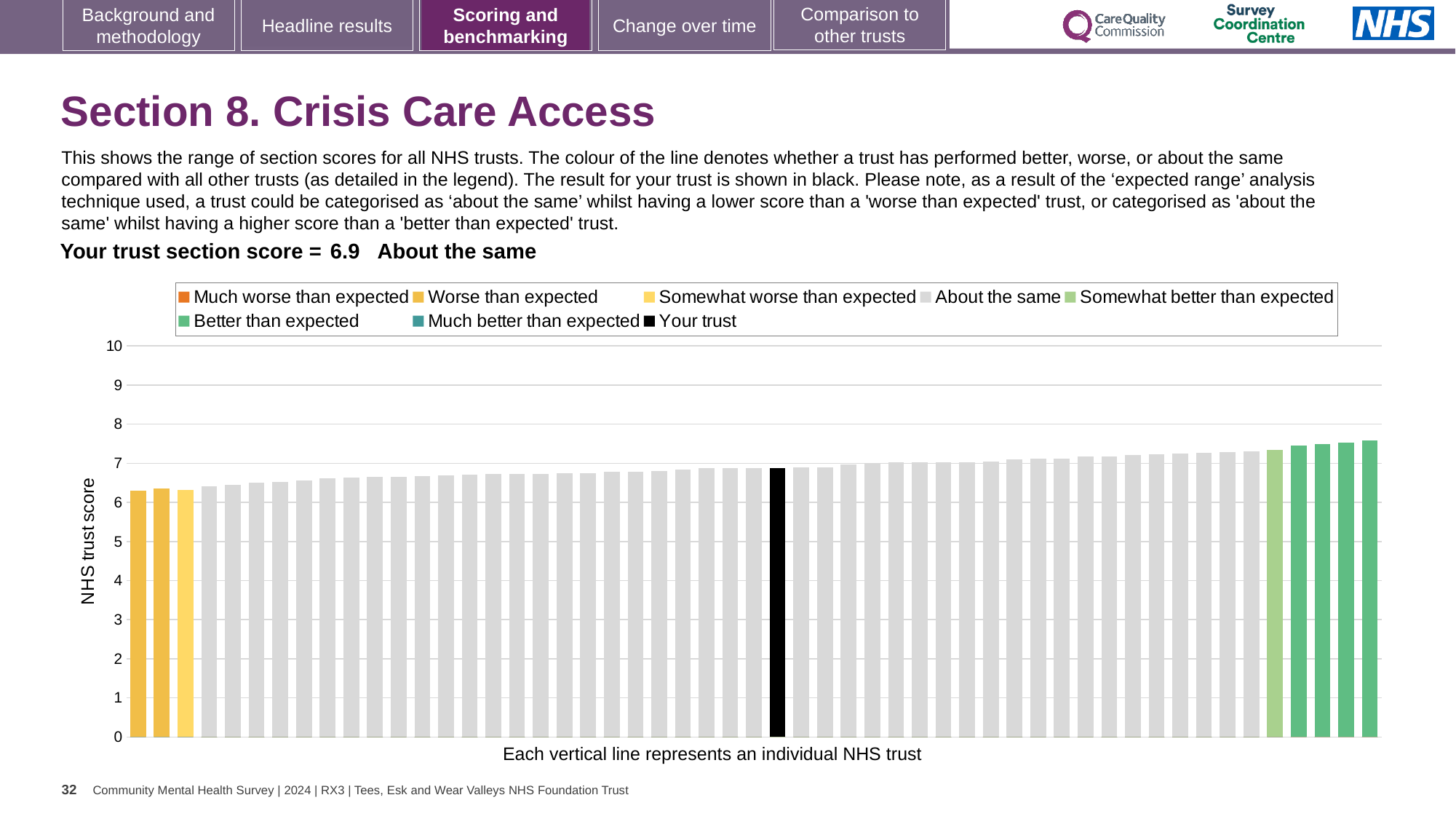
What colour is the bar representing your trust? black How many entries does the chart legend list? 8 Is the value of the tallest bar greater or less than 7? greater Which bar is taller, the leftmost bar or the rightmost bar? the rightmost bar Is your trust's score greater or less than 6? greater Is the value of the shortest bar greater or less than 6? greater Which category is your trust's section score placed in? About the same What kind of chart is shown on the slide? bar chart Do the bar values rise or fall moving from left to right along the x axis? rise What is the section score for your trust shown on the slide? 6.9 What is the label on the vertical axis of the chart? NHS trust score